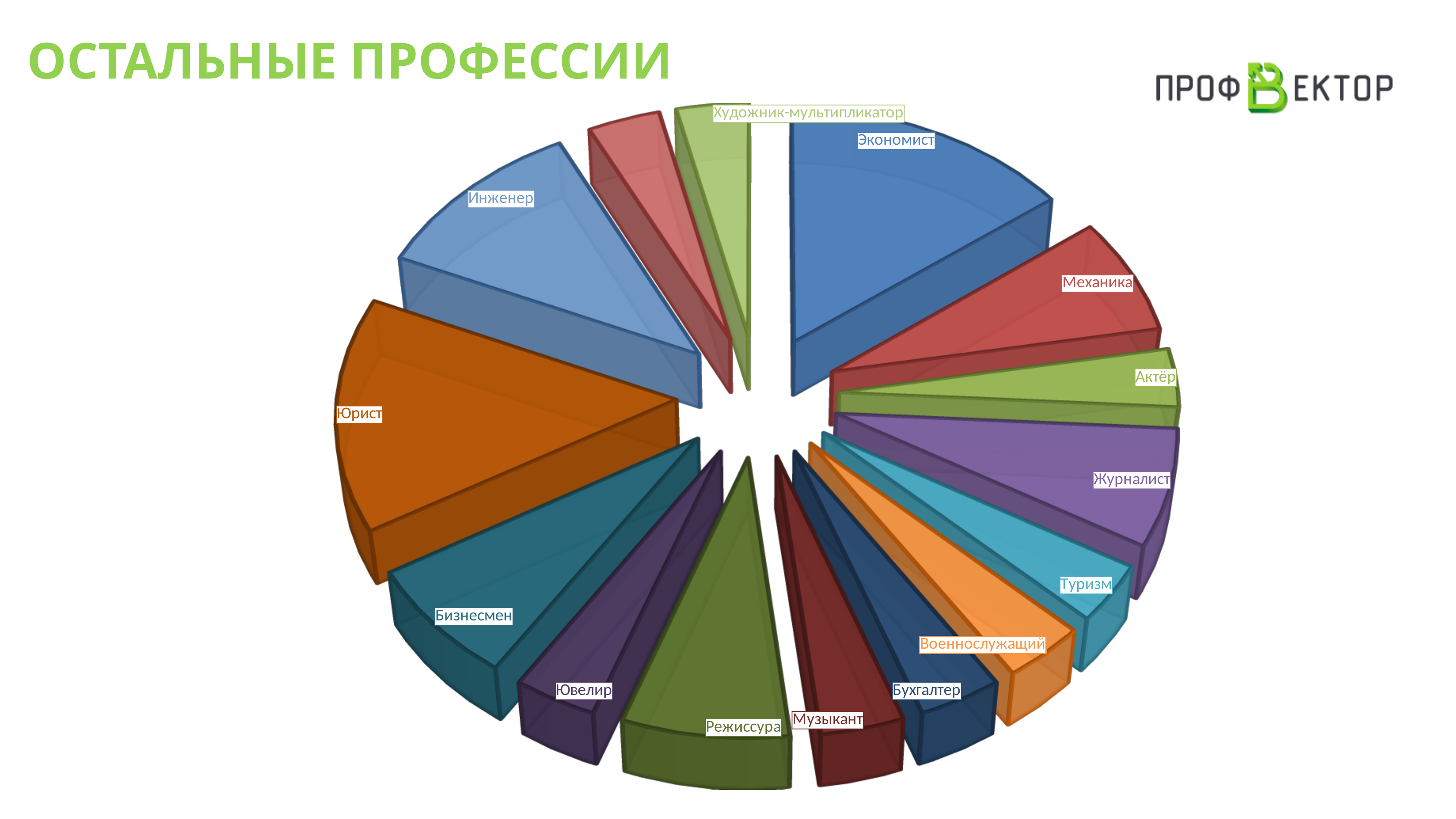
How many slices does the pie chart have? 15 What kind of chart is shown on the slide? pie chart Which slice is larger, Инженер or Бухгалтер? Инженер Which slice is larger, Механика or Военнослужащий? Механика Which slice is larger, Юрист or Актёр? Юрист What is the title of the slide with the pie chart? ОСТАЛЬНЫЕ ПРОФЕССИИ Which category label is shown on the large blue slice at the top right of the pie chart? Экономист